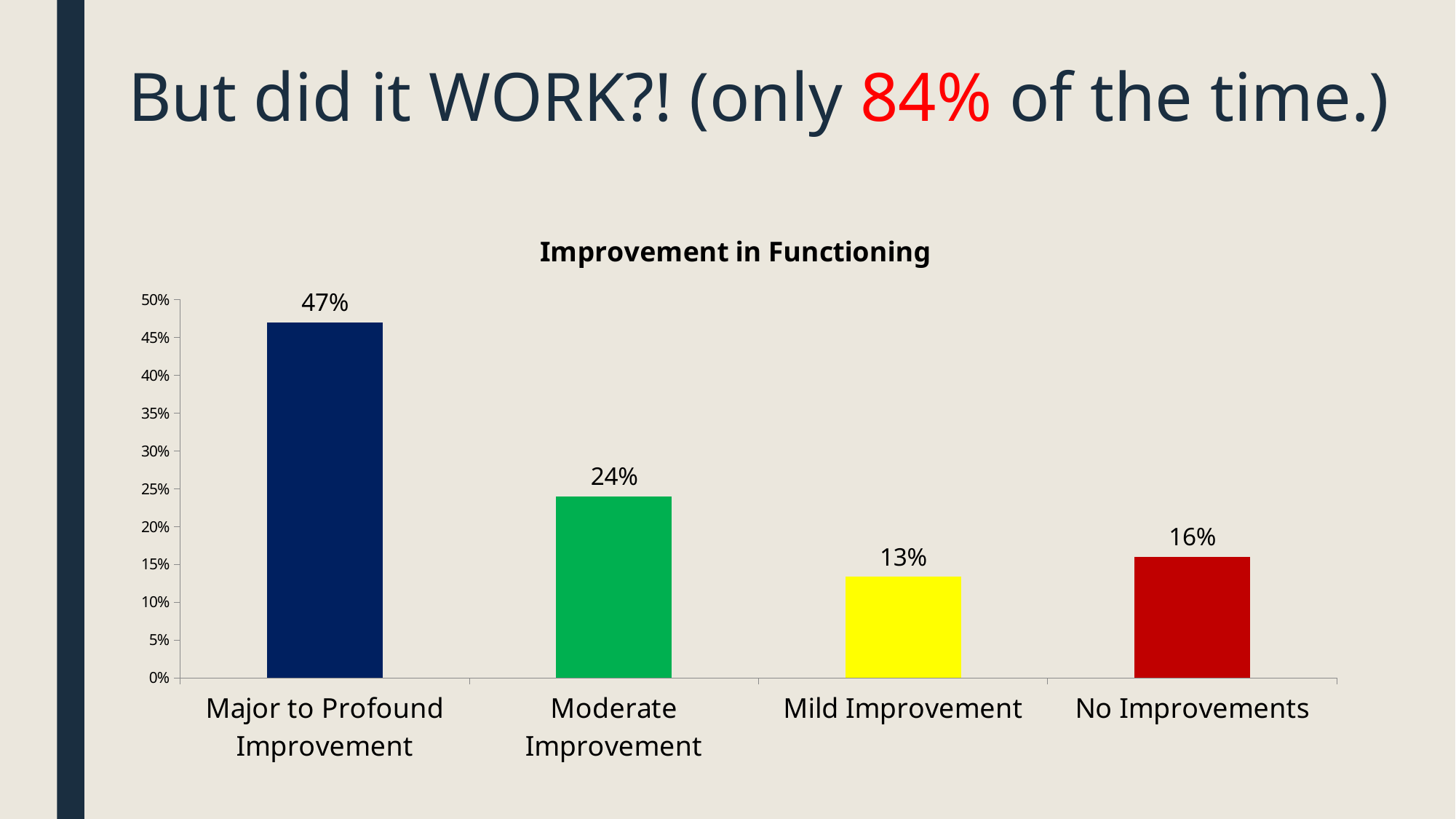
Which category has the lowest value? Mild Improvement What is the value for Moderate Improvement? 24% What kind of chart is shown on the slide? Bar chart What is the value for Mild Improvement? 13% Which is larger, No Improvements or Mild Improvement? No Improvements How many categories are shown in the chart? 4 What is the value for Major to Profound Improvement? 47% What colour is the bar for No Improvements? Red What is the value for No Improvements? 16% What is the title of the chart? Improvement in Functioning Which category has the highest value? Major to Profound Improvement What is the difference between Major to Profound Improvement and Moderate Improvement? 23%